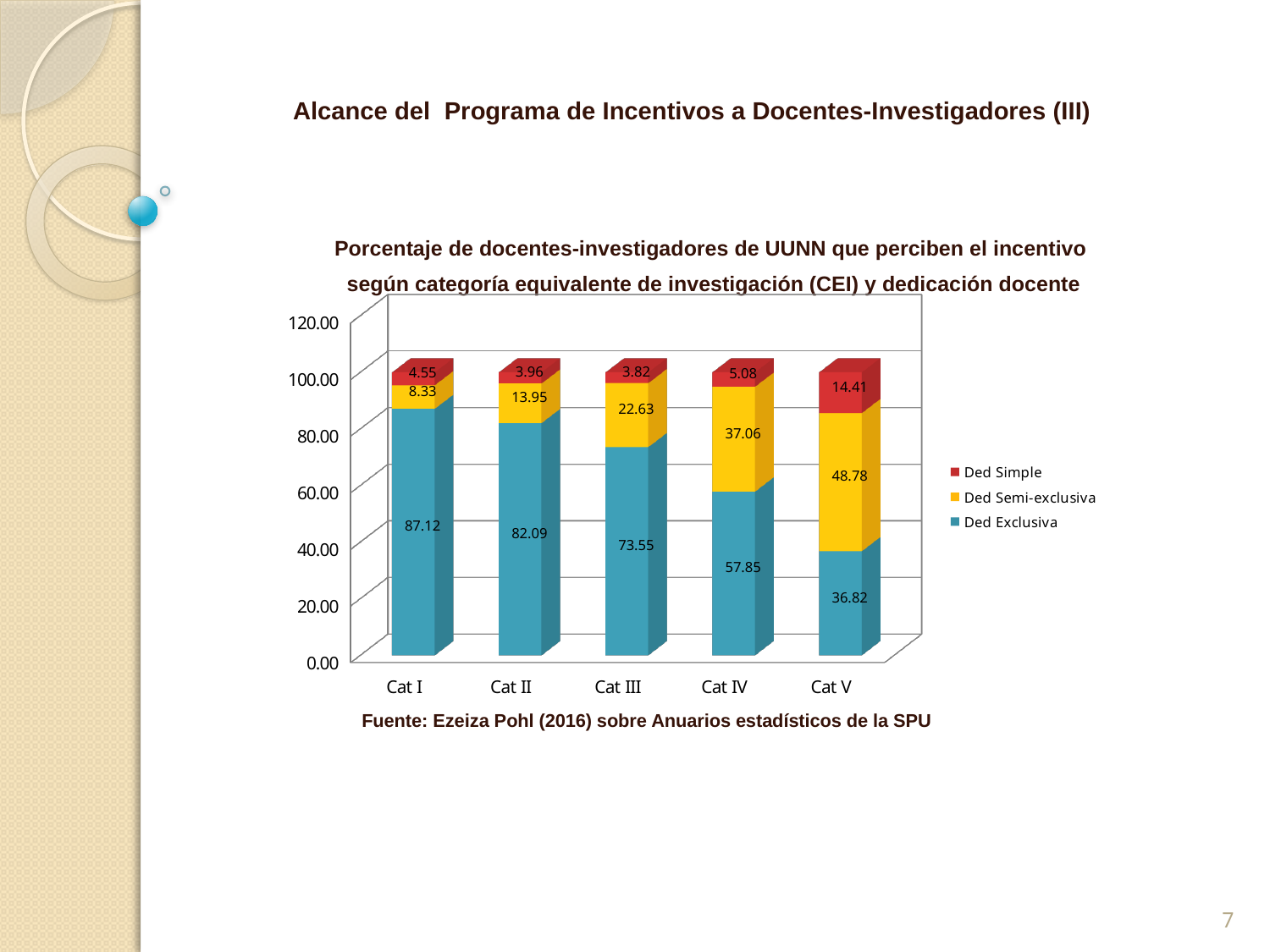
Which is larger: the Ded Semi-exclusiva value for Cat V or the Ded Exclusiva value for Cat V? Ded Semi-exclusiva (48.78) What is the Ded Simple value for Cat V? 14.41 What is the difference between the Ded Exclusiva values for Cat I and Cat V? 50.30 Does the Ded Exclusiva value rise or fall from Cat I to Cat V? Fall What kind of chart is shown? Stacked bar chart Which category has the highest Ded Exclusiva value? Cat I What is the Ded Exclusiva value for Cat III? 73.55 How many categories are shown on the x axis? 5 What is the total of the stacked bar for Cat II? 100.00 Which category has the lowest Ded Simple value? Cat III What is the Ded Semi-exclusiva value for Cat IV? 37.06 How many series does the legend list? 3